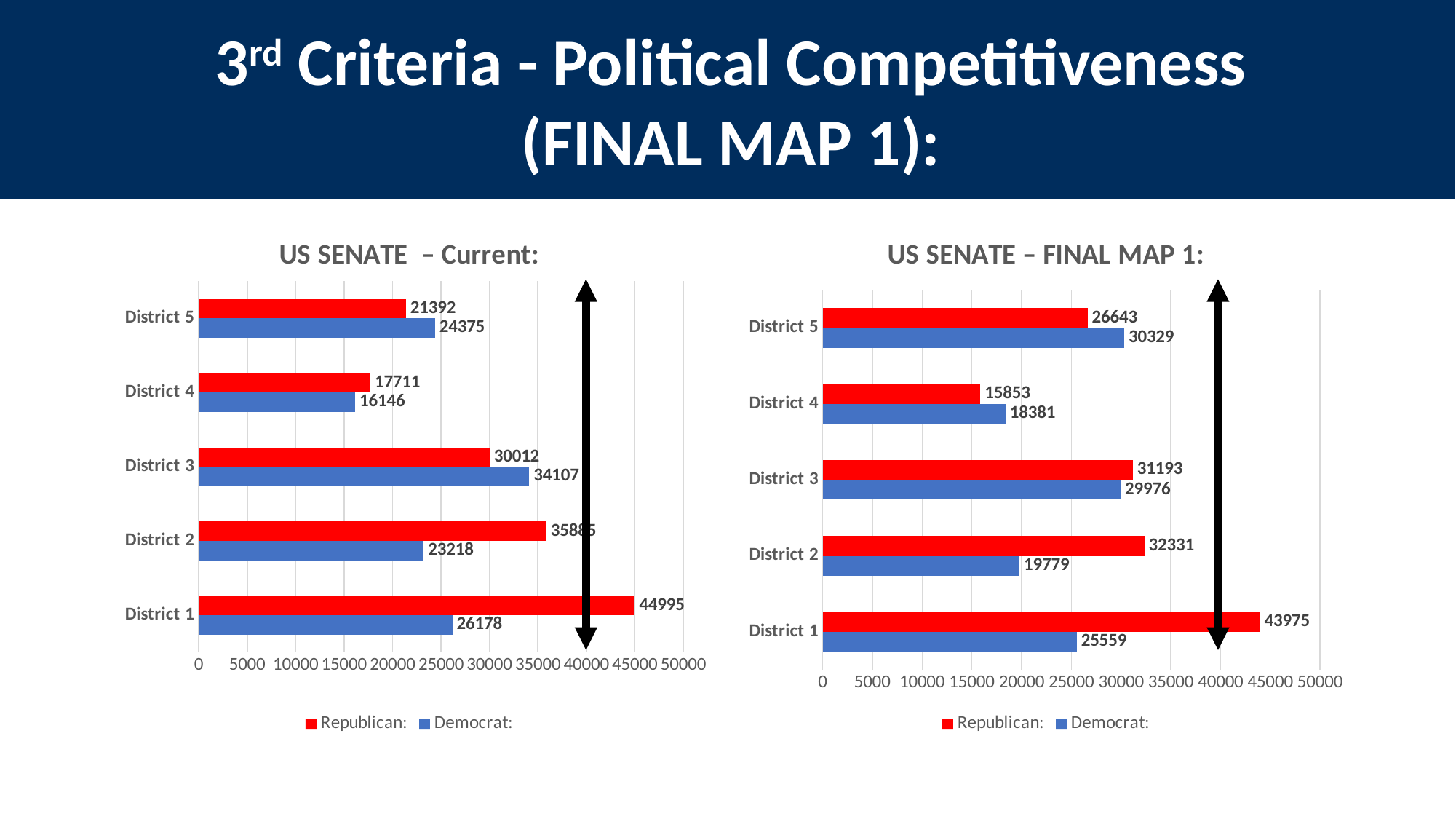
In the 'US SENATE – FINAL MAP 1' chart, is the Democrat value for District 2 greater or less than 25000? less In the 'US SENATE – Current' chart, which is larger for District 5, the Republican value or the Democrat value? Democrat How many series does the legend of the 'US SENATE – FINAL MAP 1' chart list? 2 In the 'US SENATE – Current' chart, what is the Democrat value for District 3? 34107 In the 'US SENATE – FINAL MAP 1' chart, what is the Republican value for District 4? 15853 What type of chart is the 'US SENATE – Current' chart? Bar chart How many districts are shown in the 'US SENATE – Current' chart? 5 In the 'US SENATE – Current' chart, which district has the lowest Democrat value? District 4 In the 'US SENATE – FINAL MAP 1' chart, which district has the highest Republican value? District 1 In the 'US SENATE – Current' chart, what is the Republican value for District 1? 44995 In the 'US SENATE – FINAL MAP 1' chart, what is the Democrat value for District 5? 30329 In the 'US SENATE – FINAL MAP 1' chart, what is the difference between the Republican and Democrat values for District 1? 18416